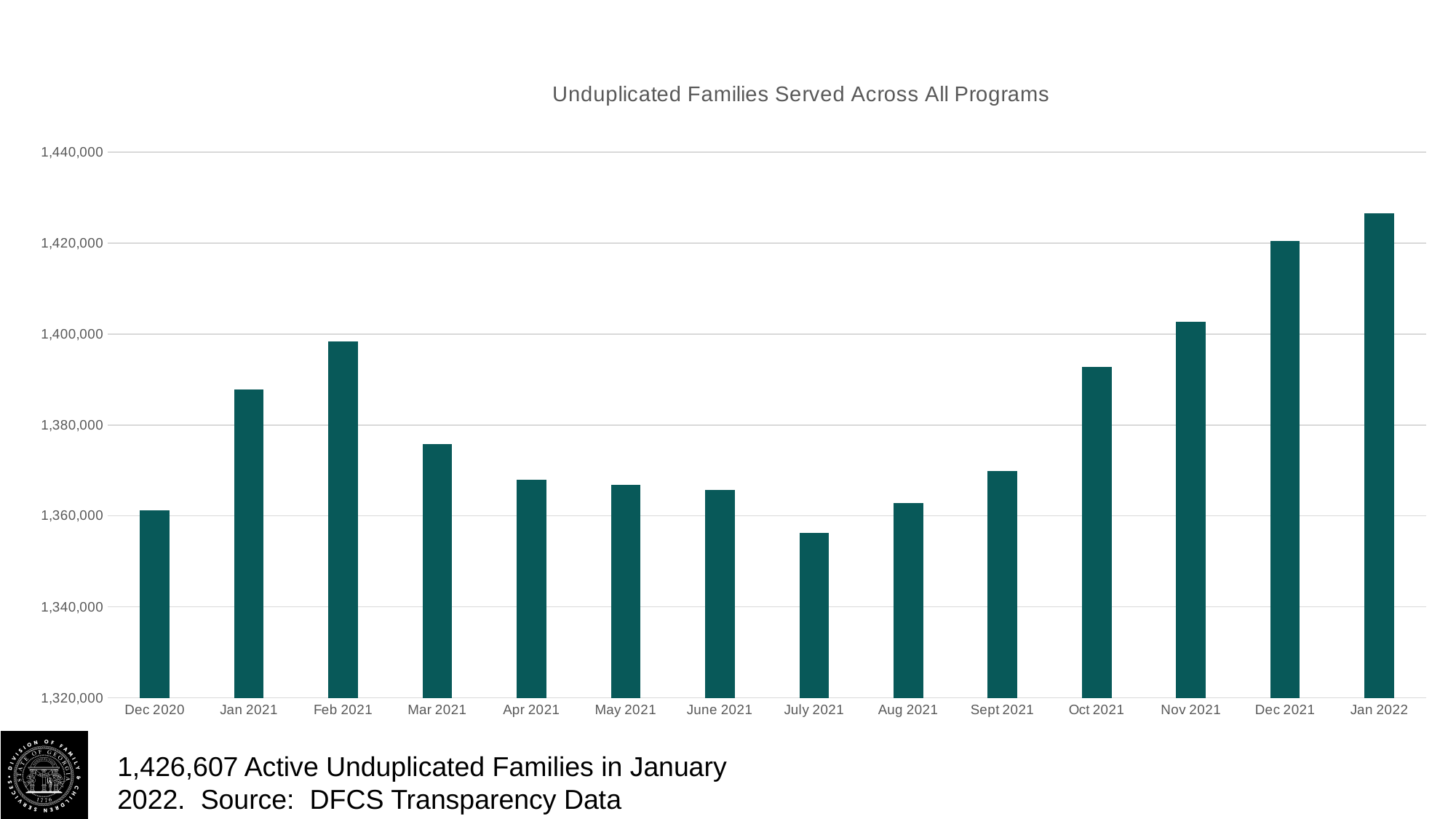
Which is larger, the value for Oct 2021 or the value for Sept 2021? Oct 2021 How many active unduplicated families were served in January 2022? 1,426,607 Is the value for Mar 2021 greater or less than 1,380,000? less Is the value for July 2021 greater or less than 1,360,000? less Is the value for Nov 2021 greater or less than 1,400,000? greater What kind of chart is shown on the slide? bar chart Which month has the highest number of unduplicated families served? Jan 2022 Which is larger, the value for Jan 2021 or the value for Apr 2021? Jan 2021 How many months are plotted on the chart? 14 Which month has the lowest number of unduplicated families served? July 2021 What is the title of the chart? Unduplicated Families Served Across All Programs